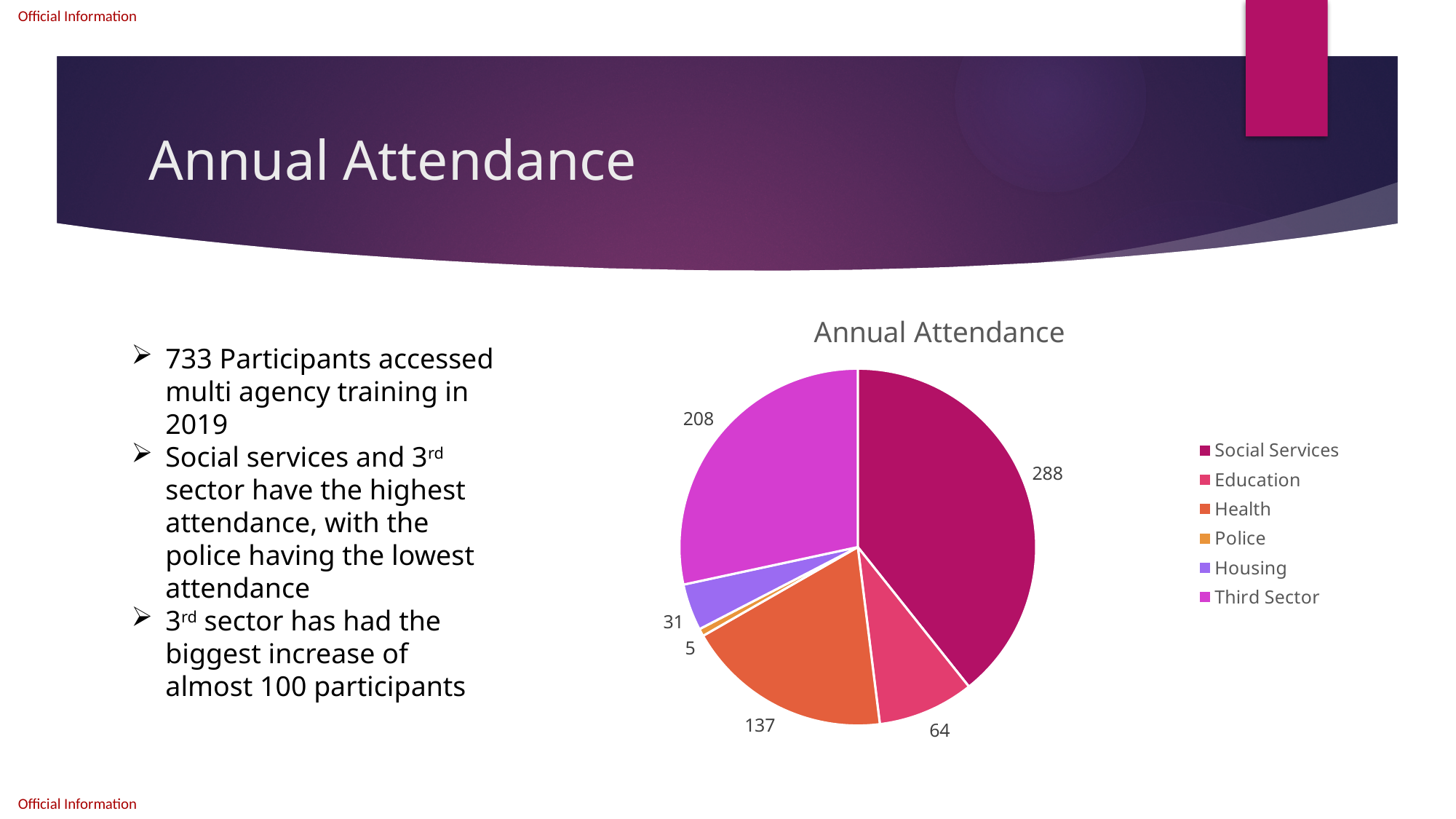
What is the value for Health in the Annual Attendance pie chart? 137 How many categories does the legend of the Annual Attendance pie chart list? 6 What is the value for Police in the Annual Attendance pie chart? 5 What is the title of the pie chart? Annual Attendance Which category has the smallest slice in the Annual Attendance pie chart? Police What is the difference between the Social Services and Third Sector values in the pie chart? 80 What type of chart is shown on the slide? pie chart What is the difference between the Health and Education values in the pie chart? 73 What is the value for Social Services in the Annual Attendance pie chart? 288 What is the value for Third Sector in the Annual Attendance pie chart? 208 Which category has the largest slice in the Annual Attendance pie chart? Social Services Which is larger in the pie chart, Housing or Education? Education